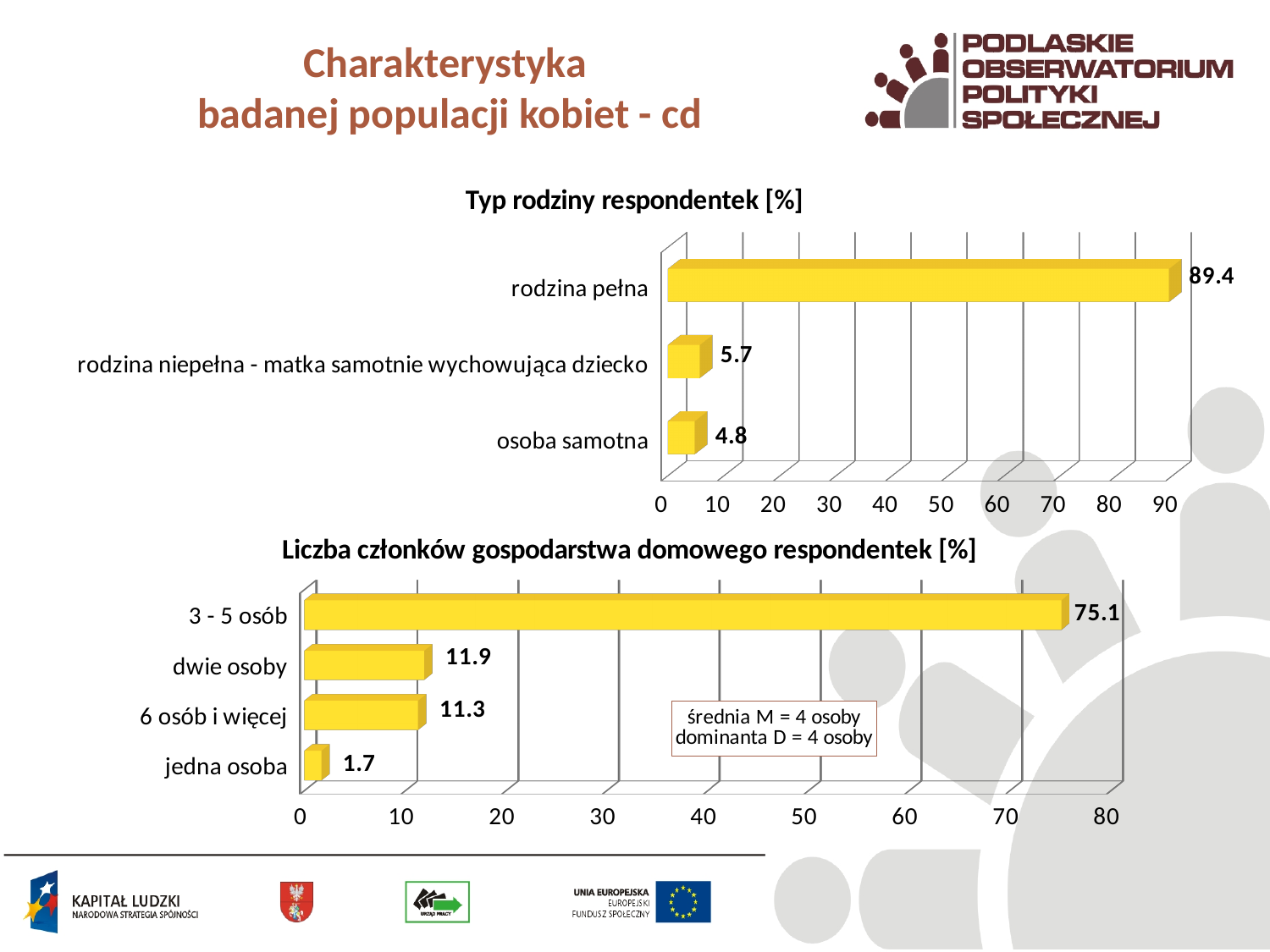
In the chart 'Liczba członków gospodarstwa domowego respondentek [%]', which is larger: 'dwie osoby' or '6 osób i więcej'? dwie osoby In the chart 'Typ rodziny respondentek [%]', which category has the lowest value? osoba samotna In the chart 'Typ rodziny respondentek [%]', what is the difference between 'rodzina niepełna - matka samotnie wychowująca dziecko' and 'osoba samotna'? 0.9 In the chart 'Liczba członków gospodarstwa domowego respondentek [%]', which category has the highest value? 3 - 5 osób In the chart 'Liczba członków gospodarstwa domowego respondentek [%]', what is the value for 'jedna osoba'? 1.7 In the chart 'Typ rodziny respondentek [%]', what is the value for 'rodzina pełna'? 89.4 In the chart 'Liczba członków gospodarstwa domowego respondentek [%]', what is the difference between '3 - 5 osób' and 'dwie osoby'? 63.2 What kind of chart is 'Liczba członków gospodarstwa domowego respondentek [%]'? bar chart In the chart 'Liczba członków gospodarstwa domowego respondentek [%]', what value is given for the mean (średnia M) in the text box? 4 osoby In the chart 'Liczba członków gospodarstwa domowego respondentek [%]', what is the value for '3 - 5 osób'? 75.1 In the chart 'Typ rodziny respondentek [%]', what is the value for 'osoba samotna'? 4.8 In the chart 'Typ rodziny respondentek [%]', how many categories are shown? 3